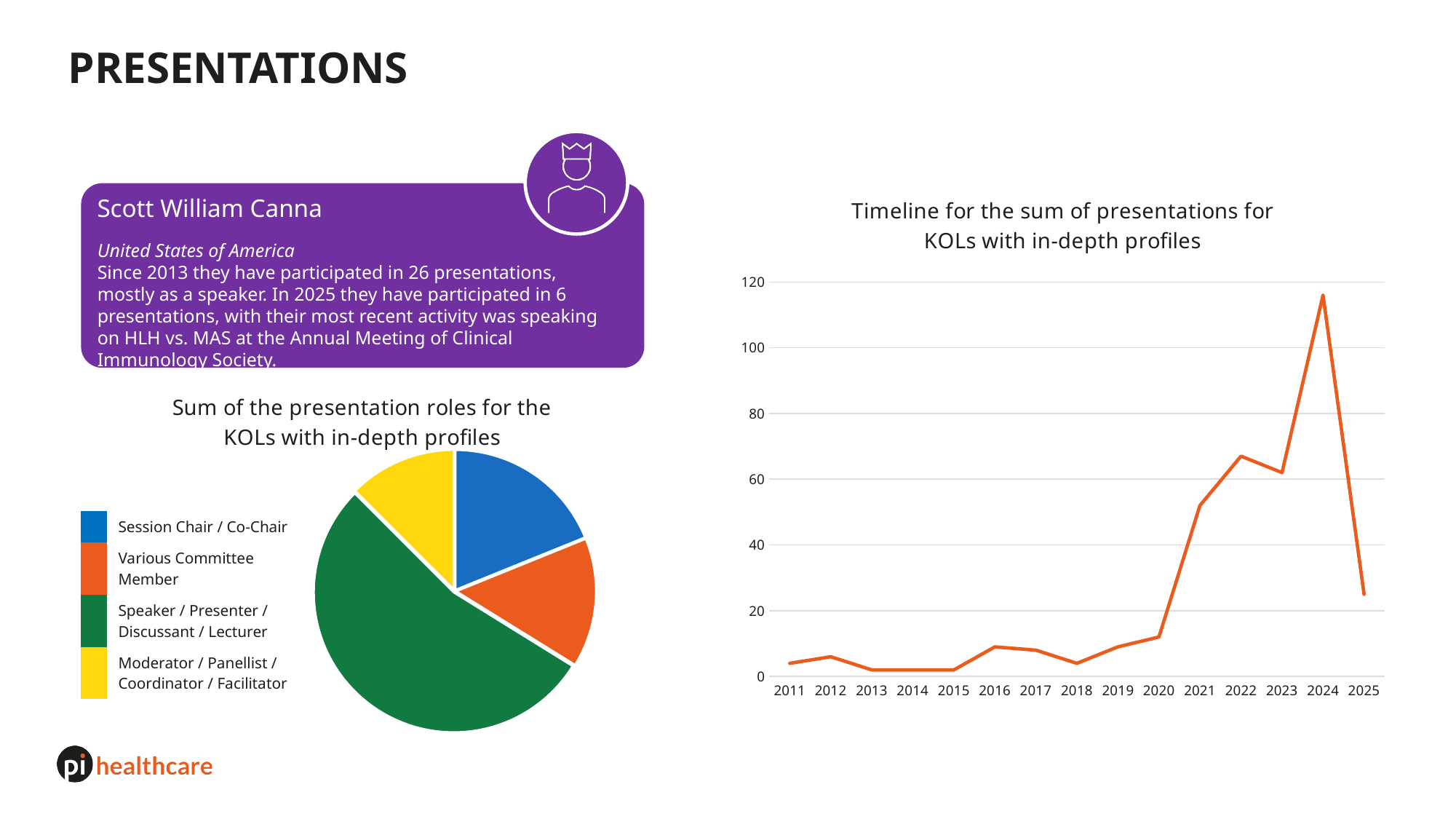
In the timeline chart on the right, is the value for 2020 greater or less than 20? less In the pie chart on the left, which is larger: the Session Chair / Co-Chair slice or the Moderator / Panellist / Coordinator / Facilitator slice? Session Chair / Co-Chair In the timeline chart on the right, is the value for 2024 greater or less than 100? greater In the pie chart on the left, what colour is the Various Committee Member slice? Orange In the timeline chart on the right, how many years are shown on the x axis? 15 In the pie chart on the left, which role has the largest share? Speaker / Presenter / Discussant / Lecturer In the pie chart on the left, how many categories does the legend list? 4 In the timeline chart on the right, is the value for 2021 greater or less than 40? greater What kind of chart is the 'Sum of the presentation roles for the KOLs with in-depth profiles' chart? Pie chart In the timeline chart on the right, which year has the highest sum of presentations? 2024 In the timeline chart on the right, does the value rise or fall from 2024 to 2025? Fall What kind of chart is the 'Timeline for the sum of presentations for KOLs with in-depth profiles' chart? Line chart